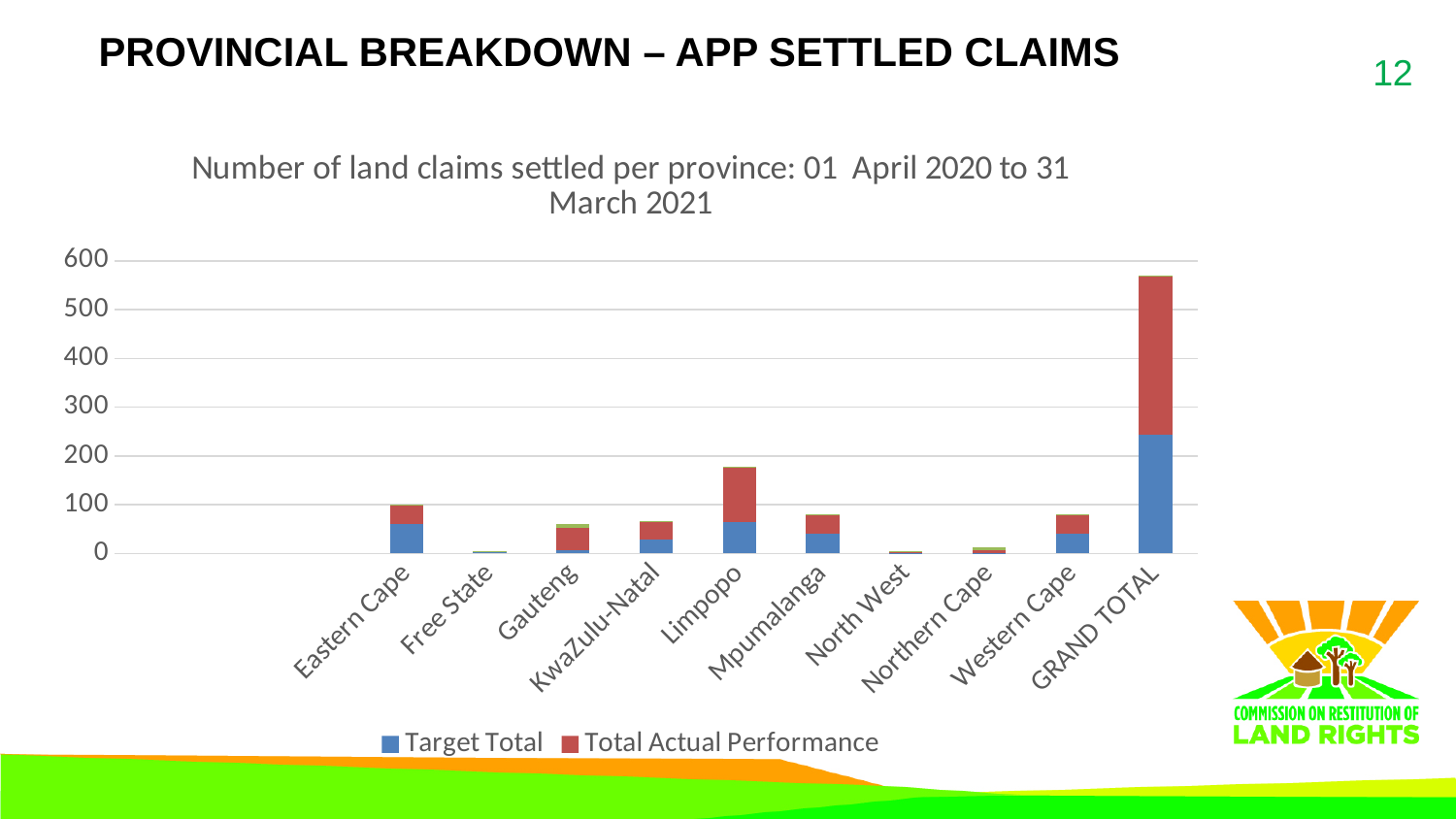
How many categories are shown along the x axis of the chart? 10 Which series is shown in blue in the chart legend? Target Total Is the total stacked value for GRAND TOTAL greater or less than 500? greater Is the total stacked value for Gauteng greater or less than 100? less Which category has the tallest stacked bar in the chart? GRAND TOTAL What is the title of the chart? Number of land claims settled per province: 01 April 2020 to 31 March 2021 How many series does the chart legend list? 2 Is the total stacked value for Limpopo greater or less than 100? greater What kind of chart is shown on the slide? Stacked bar chart Which has the taller stacked bar, Limpopo or Mpumalanga? Limpopo Excluding GRAND TOTAL, which province has the tallest stacked bar? Limpopo